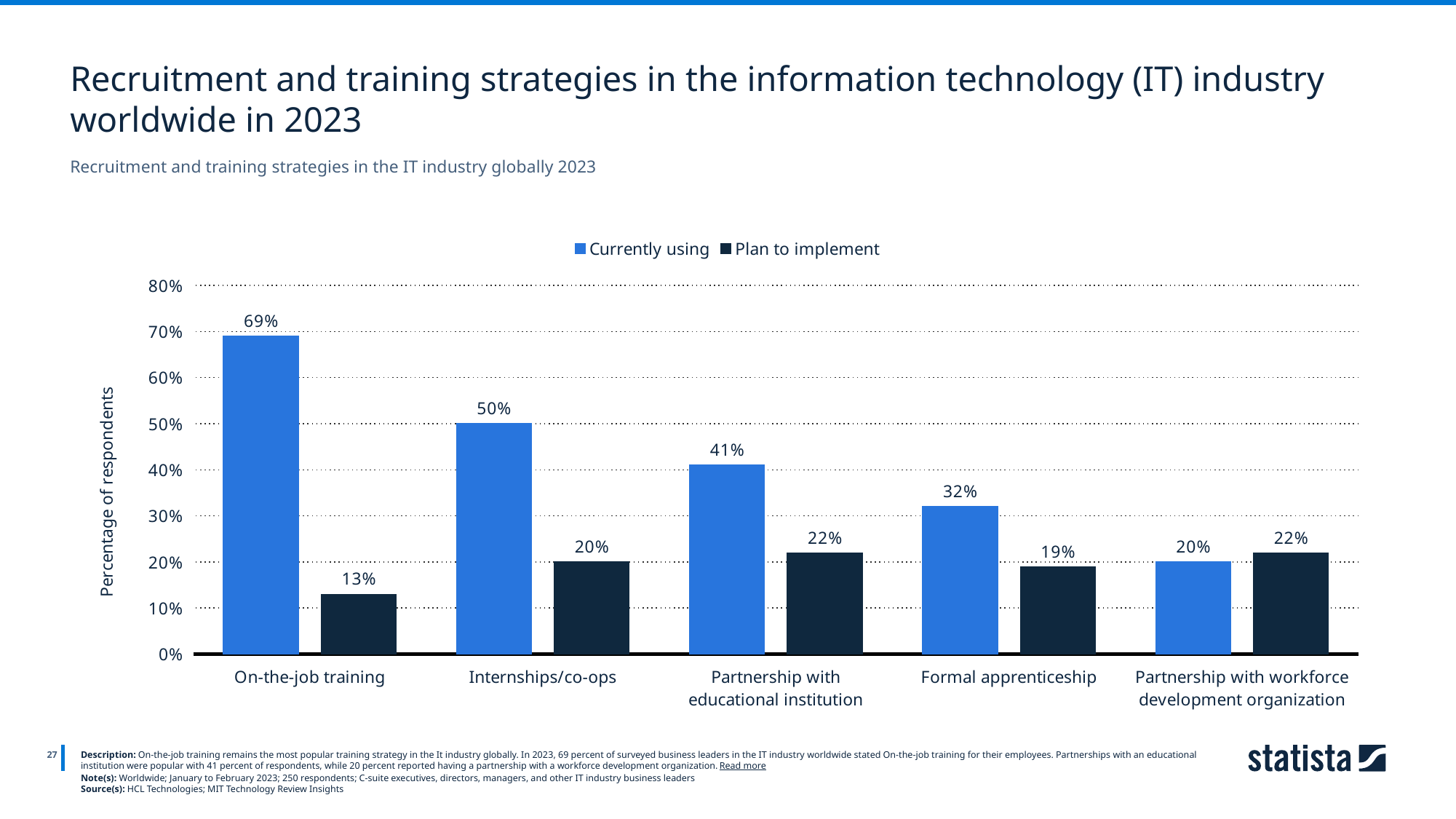
Which strategy has the lowest 'Plan to implement' value? On-the-job training What is the difference between the 'Currently using' and 'Plan to implement' values for internships/co-ops? 30 percentage points What percentage of respondents plan to implement formal apprenticeship? 19% What is the 'Currently using' value for partnership with educational institution? 41% Which strategy has the highest 'Currently using' value? On-the-job training What percentage of respondents are currently using on-the-job training? 69% What is the label of the y axis? Percentage of respondents How many recruitment and training strategies are shown on the x axis? 5 What kind of chart is shown on the slide? Bar chart Is the 'Currently using' value for formal apprenticeship greater or less than 30%? greater How many series does the legend list? 2 For partnership with workforce development organization, which is larger: 'Currently using' or 'Plan to implement'? Plan to implement